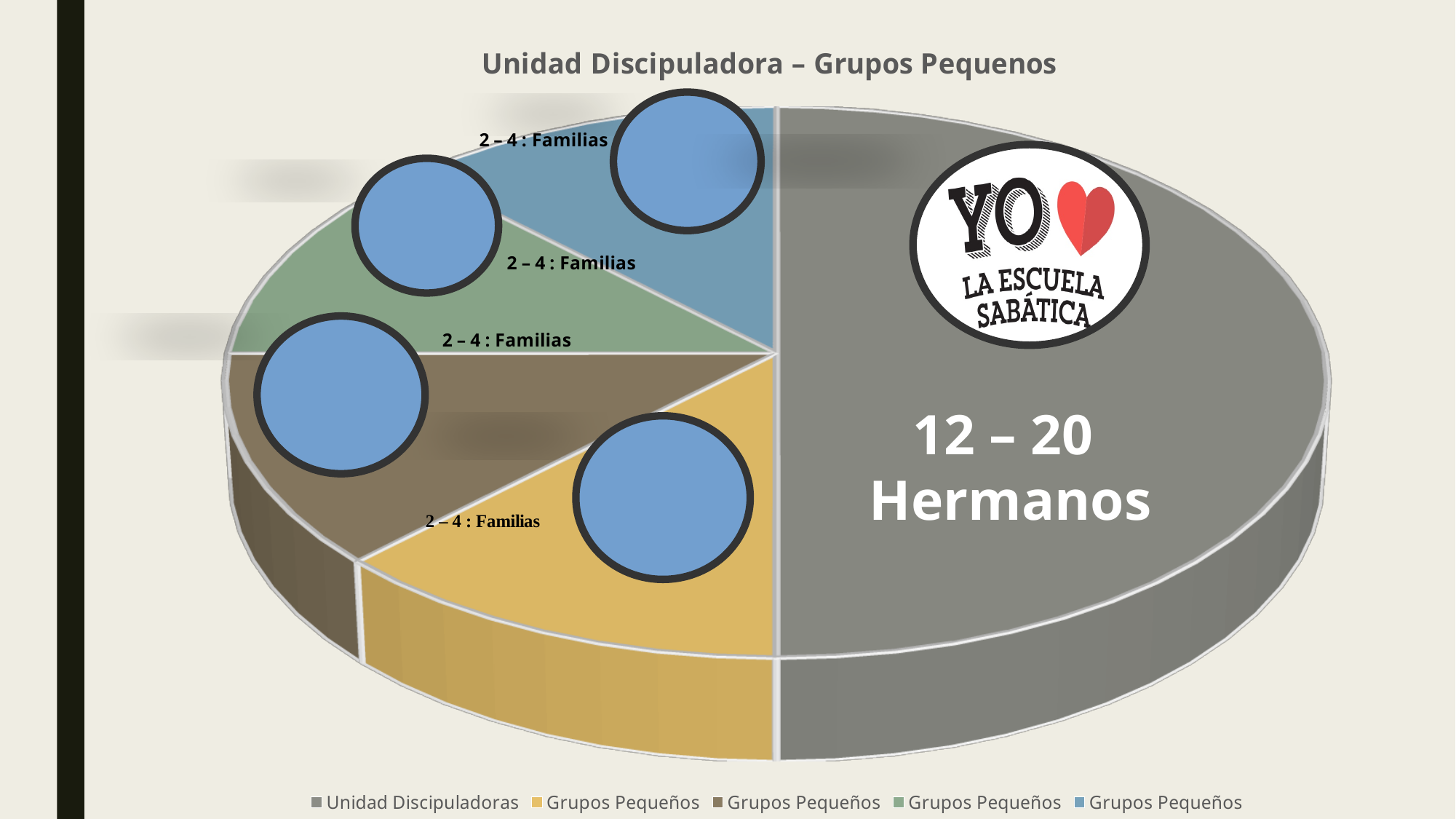
What label is written on each of the Grupos Pequeños slices? 2 – 4 : Familias How many legend entries are named Grupos Pequeños? 4 What kind of chart is shown on the slide? Pie chart What is the title of the chart? Unidad Discipuladora – Grupos Pequenos What text is written on the largest (gray) slice of the pie? 12 – 20 Hermanos What colour is the Unidad Discipuladoras slice? Gray How many entries does the chart legend list? 5 Which legend category corresponds to the largest slice of the pie? Unidad Discipuladoras Which is larger: the Unidad Discipuladoras slice or the yellow Grupos Pequeños slice? Unidad Discipuladoras How many slices does the pie chart have? 5